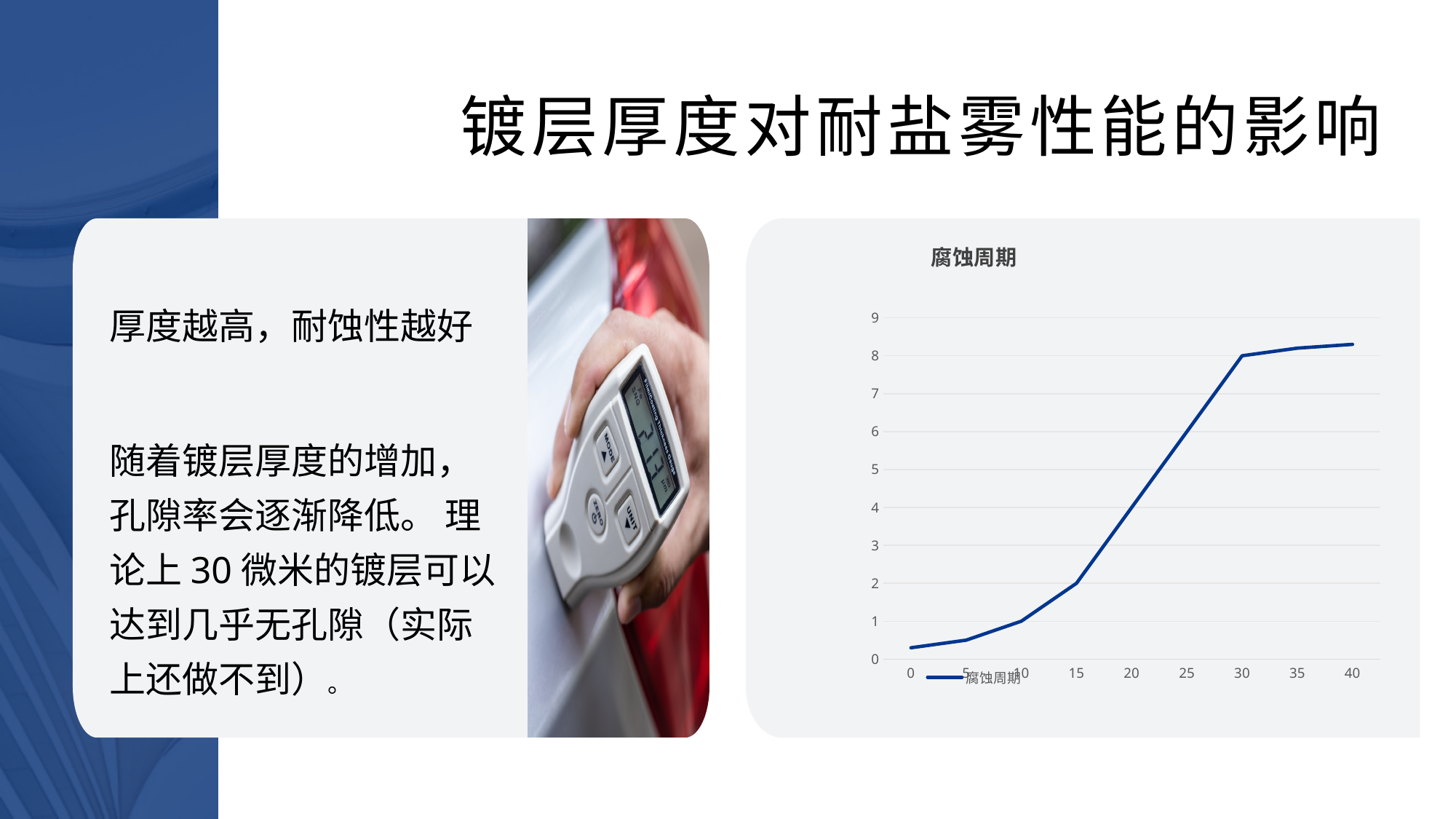
How many tick labels are shown on the x axis? 9 At which x-axis value is the plotted value highest? 40 Do the values in the chart rise or fall as the x axis increases from 0 to 40? rise Is the value at x = 20 greater or less than 3? greater What kind of chart is shown on the slide? line chart How many series does the chart legend list? 1 What is the title of the chart? 腐蚀周期 Which is larger, the value at x = 30 or the value at x = 15? x = 30 At which x-axis value is the plotted value lowest? 0 Is the value at x = 25 greater or less than 5? greater Is the value at x = 35 greater or less than 9? less